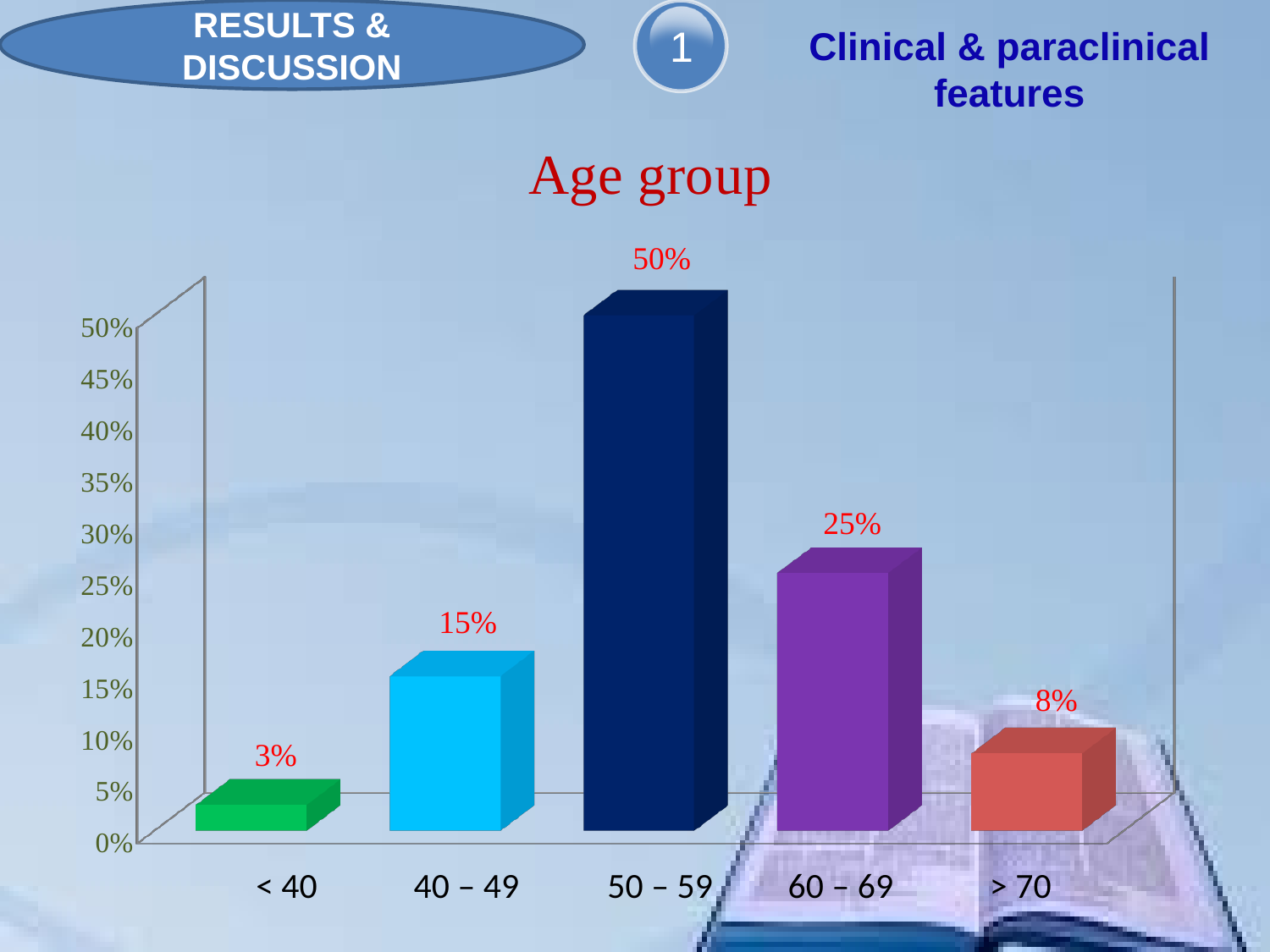
Which age group has the lowest value? < 40 What is the difference between the values for 40 – 49 and > 70? 7% What kind of chart is shown on the slide? bar chart What is the value for the < 40 age group? 3% What is the value for the > 70 age group? 8% Is the value for 60 – 69 greater or less than 20%? greater What is the title of the chart? Age group Which age group has the highest value? 50 – 59 What is the value for the 50 – 59 age group? 50% How many age groups are shown in the chart? 5 What is the difference between the values for 50 – 59 and 60 – 69? 25% Which is larger, the value for 40 – 49 or the value for > 70? 40 – 49